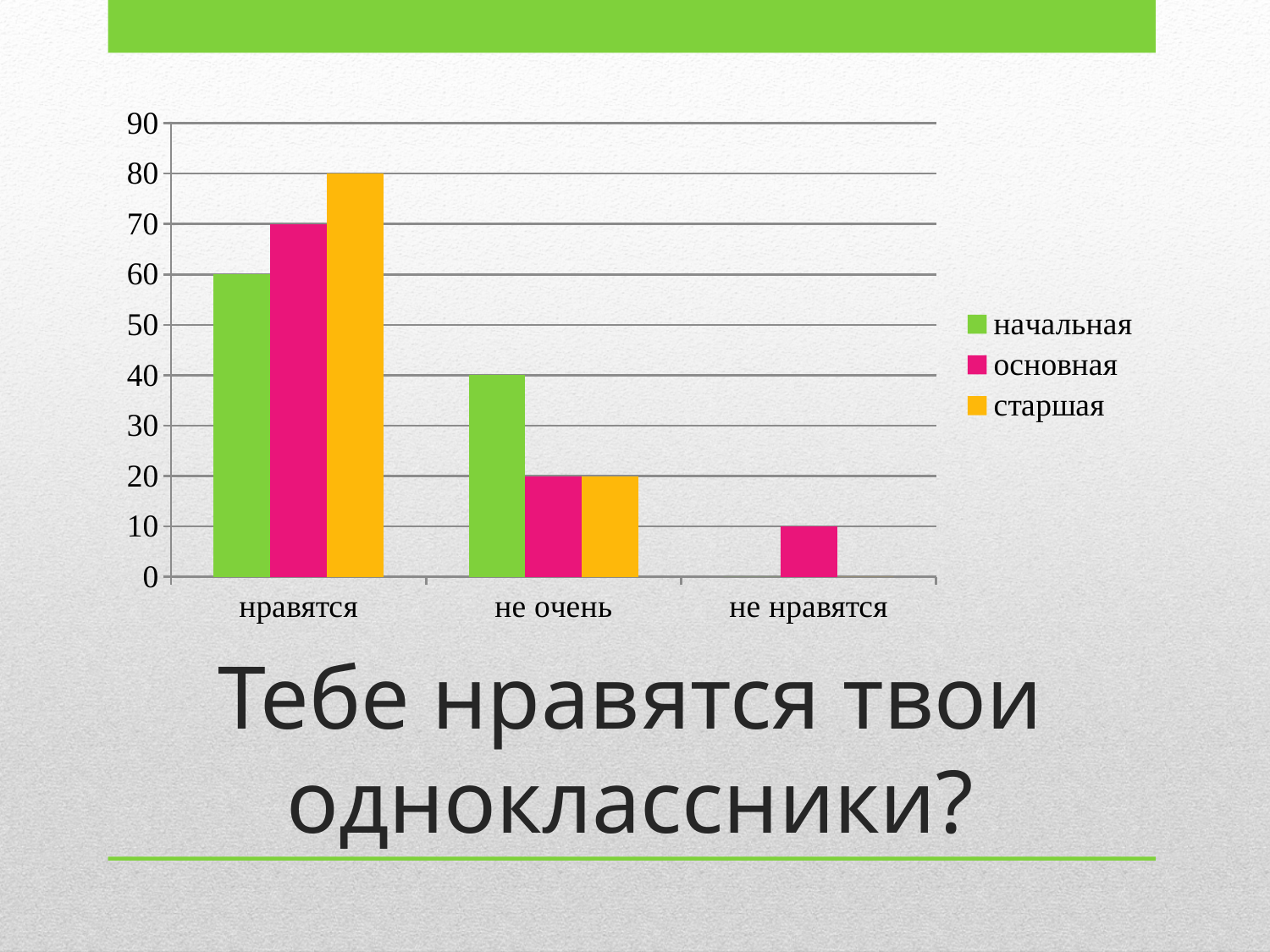
Is the value for основная in the нравятся category greater or less than 50? greater How many series does the legend list? 3 What colour are the bars for the старшая series? orange Which series has the lowest value in the нравятся category? начальная What is the value for старшая in the нравятся category? 80 What kind of chart is shown on the slide? bar chart What is the difference between the старшая and начальная values in the нравятся category? 20 How many categories are shown on the x axis? 3 What is the value for начальная in the не очень category? 40 What is the value for основная in the не нравятся category? 10 Which series has the highest value in the нравятся category? старшая Which is larger: the начальная value for не очень or the основная value for не очень? начальная